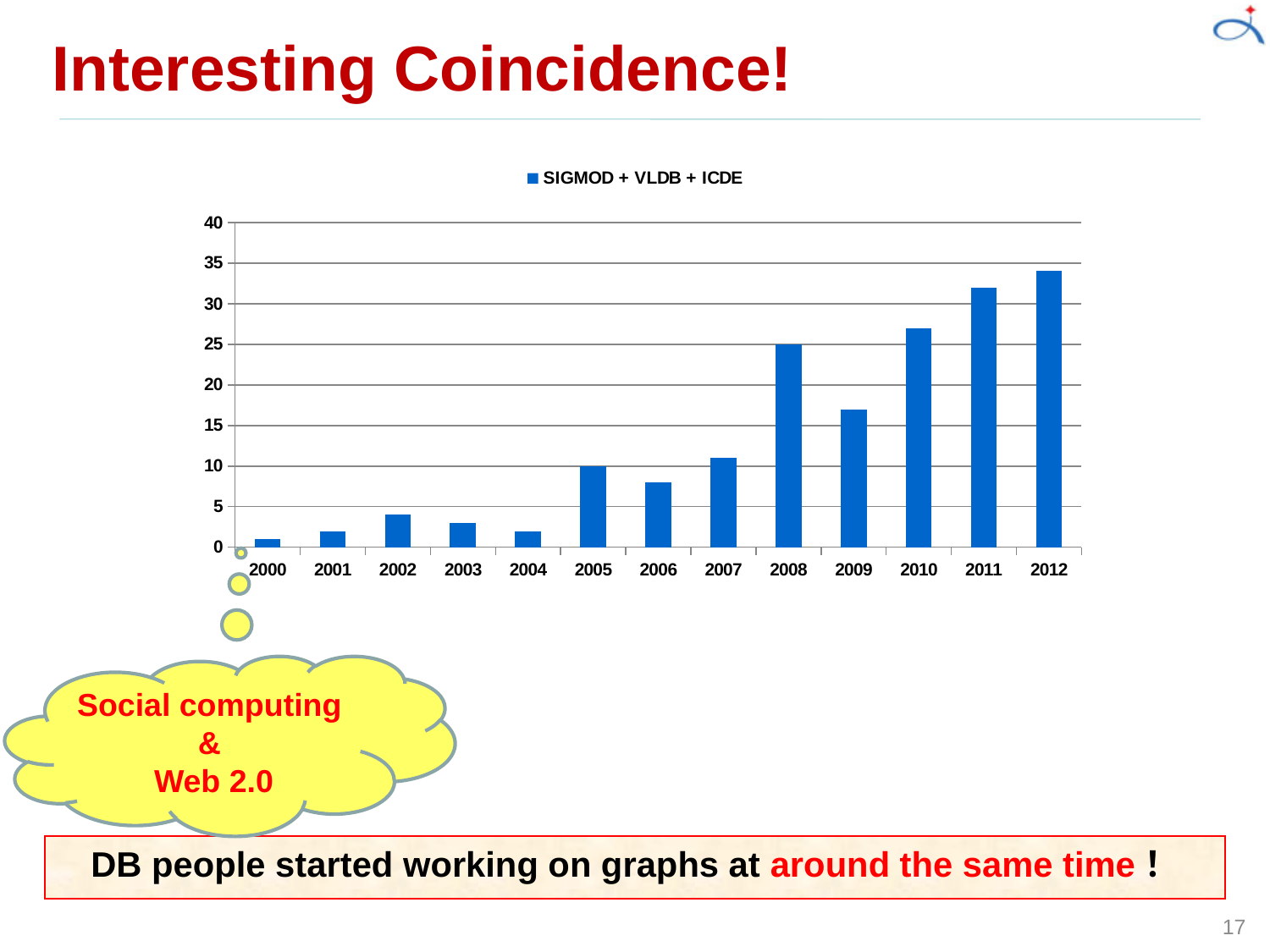
How many years are shown on the x axis of the chart? 13 Is the value for 2000 greater or less than 5? less Is the value for 2009 greater or less than 20? less What is the name of the series shown in the chart legend? SIGMOD + VLDB + ICDE How many series does the chart legend list? 1 Which year has the highest bar in the chart? 2012 Is the value for 2012 greater or less than 30? greater Which year has the lowest bar in the chart? 2000 Which year has the larger value, 2008 or 2009? 2008 Which year has the larger value, 2005 or 2006? 2005 Overall, do the values rise or fall from 2000 to 2012? rise What type of chart is shown on the slide? bar chart